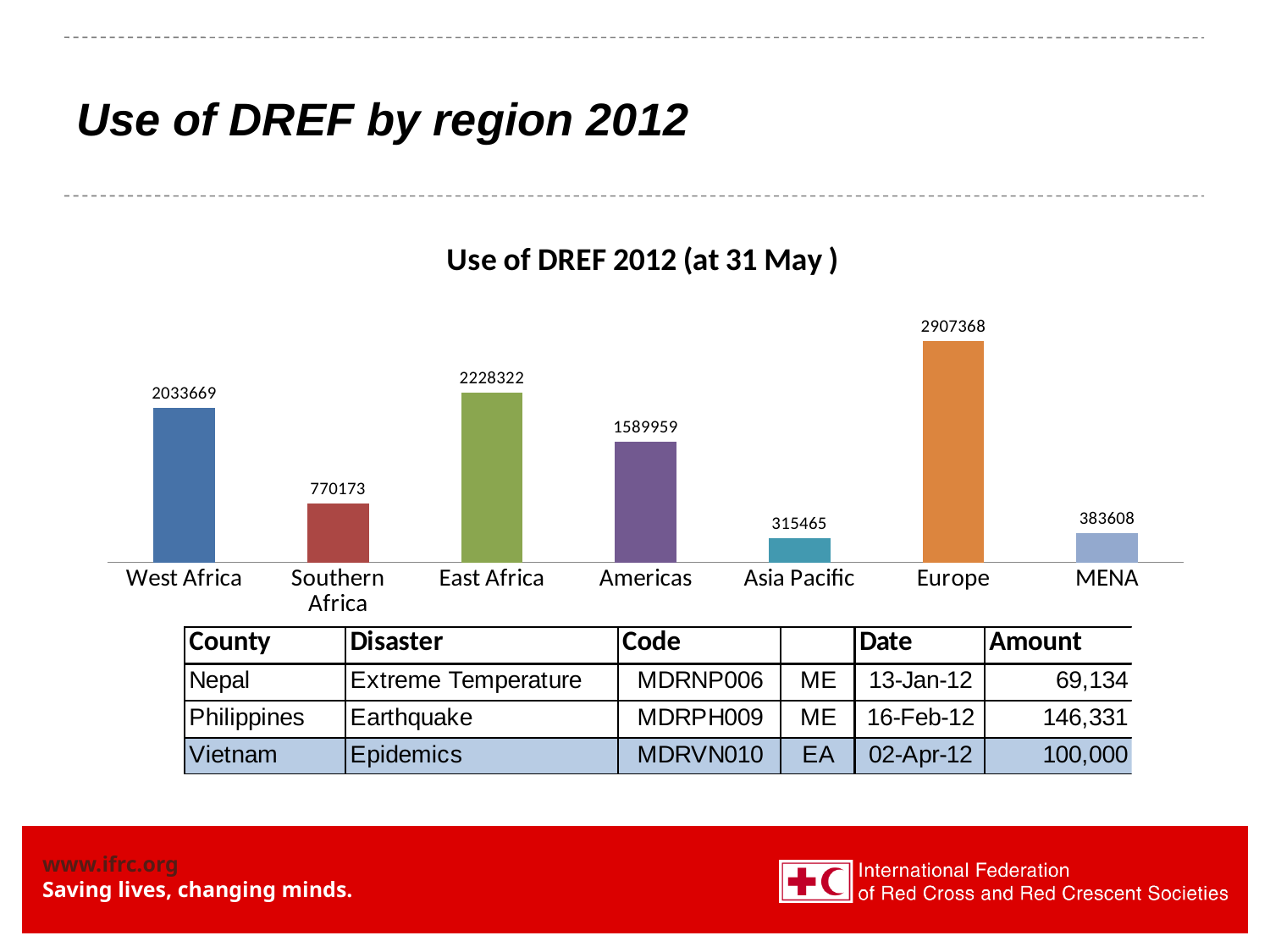
How many regions are shown in the chart? 7 Which is larger, the value for East Africa or the value for West Africa? East Africa Which region has the highest value in the chart? Europe What is the difference between the values for Europe and East Africa? 679046 What is the value for Europe in the chart? 2907368 What is the difference between the values for West Africa and Southern Africa? 1263496 What is the value for Asia Pacific in the chart? 315465 What is the title of the chart? Use of DREF 2012 (at 31 May ) What is the value for Southern Africa in the chart? 770173 What is the value for Americas in the chart? 1589959 What kind of chart is shown on the slide? Bar chart Which region has the lowest value in the chart? Asia Pacific